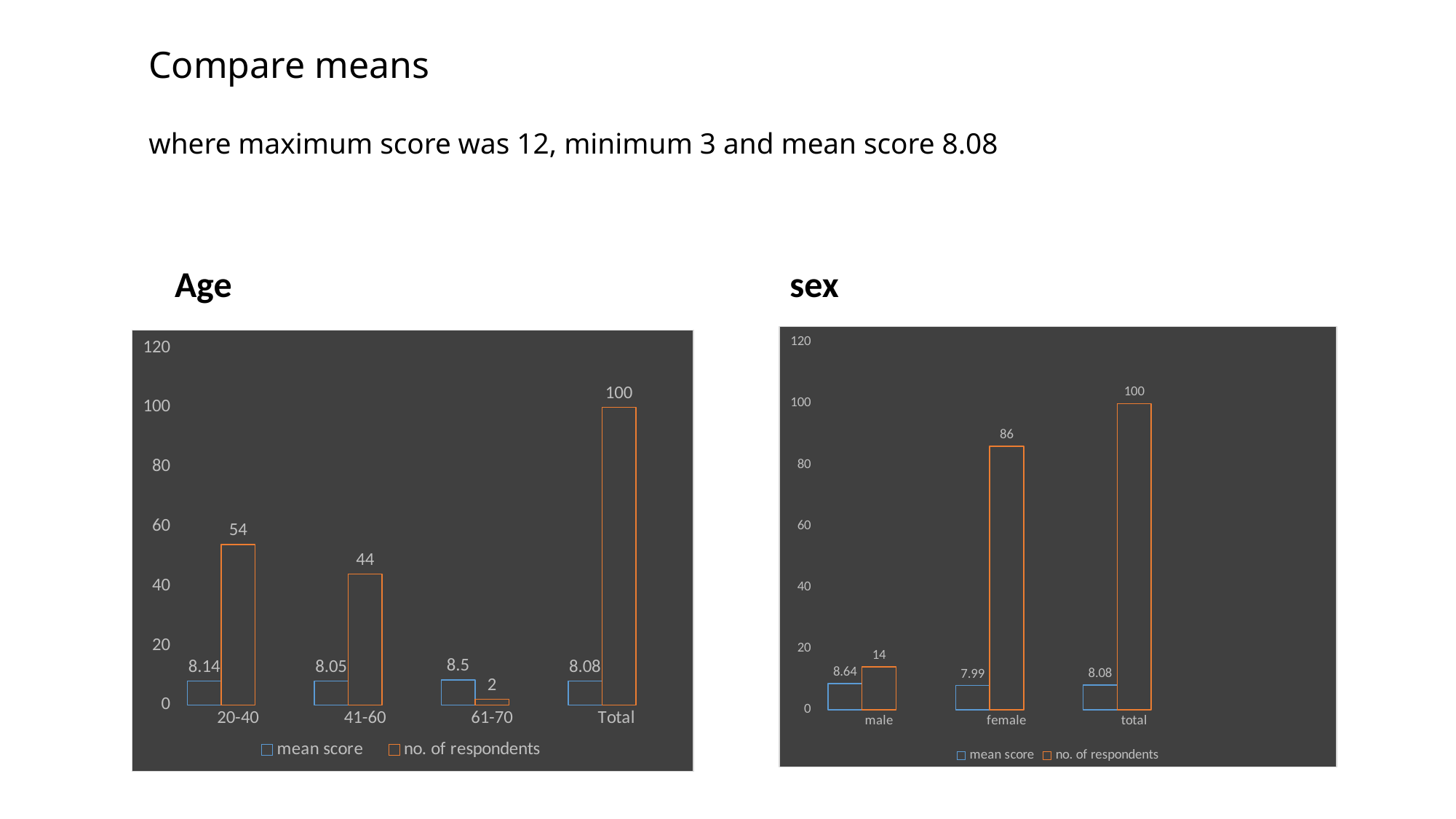
What type of chart is the Age chart? bar chart In the Age chart, is the number of respondents for the 41-60 group greater or less than 60? less In the Age chart, which age group has the fewest respondents? 61-70 In the Age chart, how many categories are shown on the x axis? 4 In the Age chart, what is the difference in number of respondents between the 20-40 and 41-60 groups? 10 In the sex chart, how many female respondents are there? 86 In the Age chart, what is the mean score for the 61-70 age group? 8.5 In the sex chart, how many series does the legend list? 2 In the sex chart, what is the mean score for male respondents? 8.64 In the sex chart, which has the higher mean score, male or female? male In the sex chart, what is the difference in number of respondents between female and male? 72 In the Age chart, how many respondents are in the 20-40 age group? 54